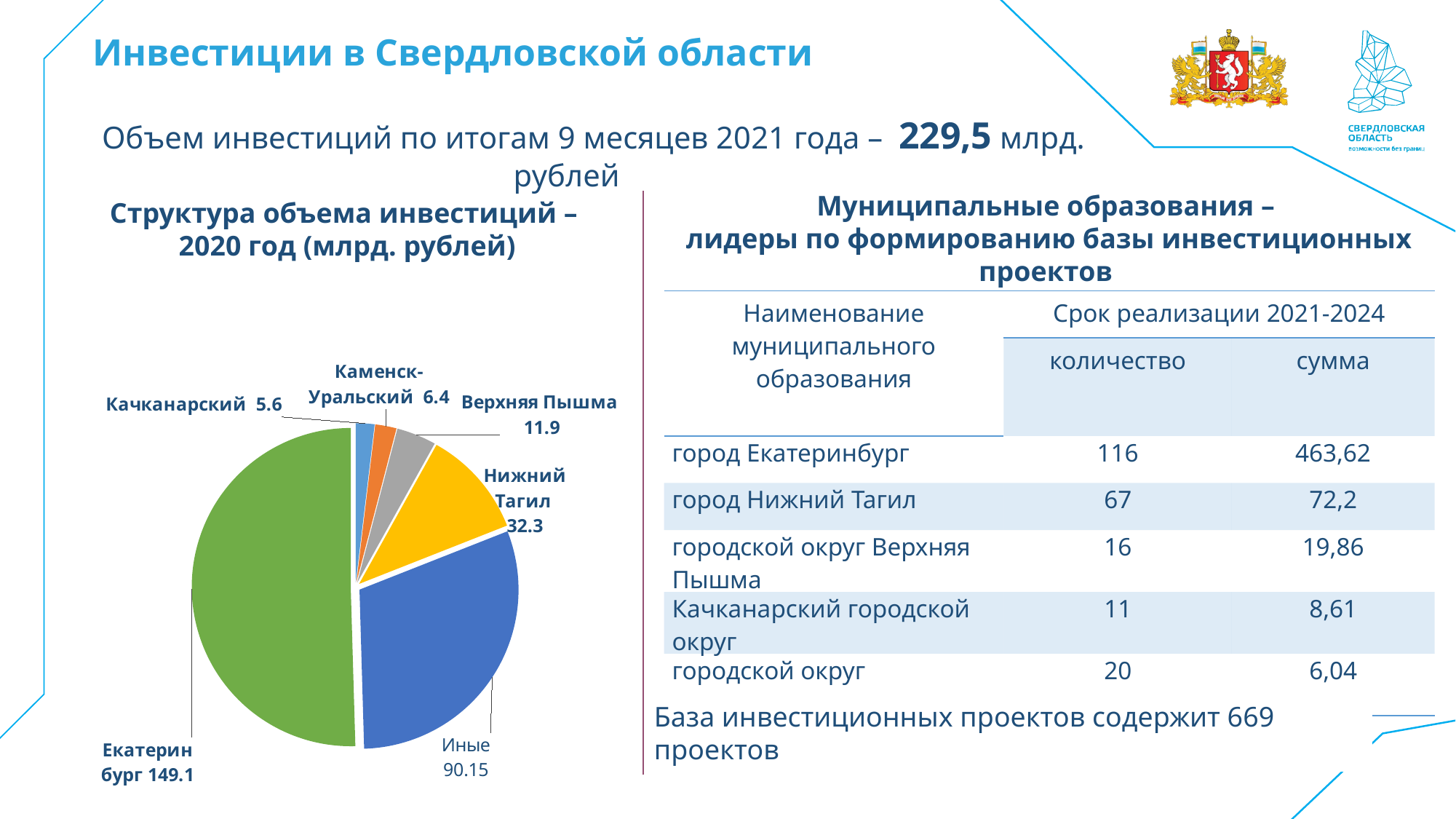
What is the value for Иные in the pie chart? 90.15 What is the title of the pie chart? Структура объема инвестиций – 2020 год (млрд. рублей) What is the value for Екатеринбург in the pie chart? 149.1 Which category has the largest slice in the pie chart? Екатеринбург Which category has the smallest slice in the pie chart? Качканарский What is the value for Верхняя Пышма in the pie chart? 11.9 What colour is the Екатеринбург slice in the pie chart? green What type of chart is shown on the slide? pie chart How many slices does the pie chart have? 6 What is the value for Нижний Тагил in the pie chart? 32.3 Which is larger in the pie chart: Нижний Тагил or Верхняя Пышма? Нижний Тагил What is the difference between the values for Екатеринбург and Иные in the pie chart? 58.95